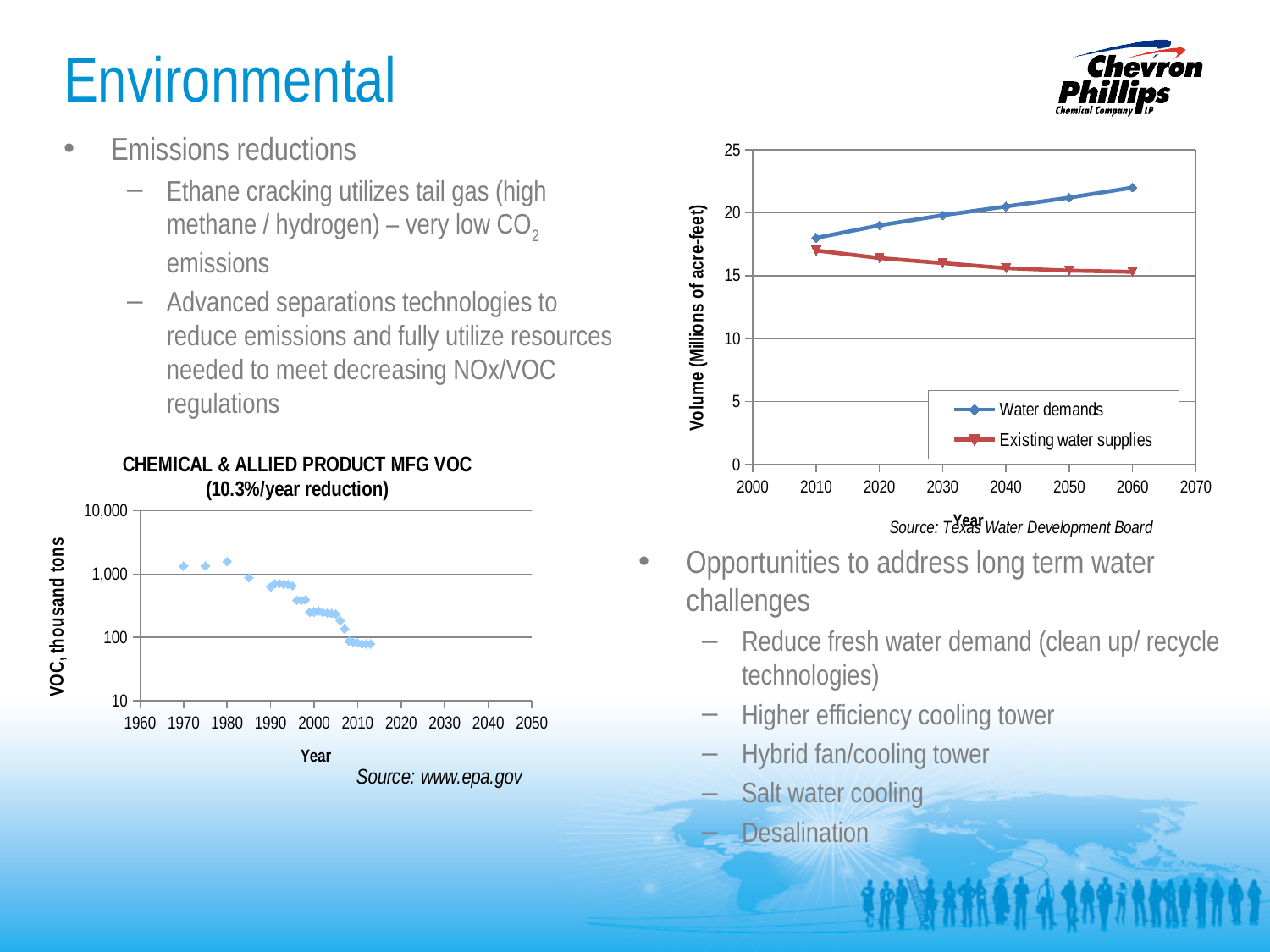
On the water chart on the right, how many data points are plotted for the Water demands series? 6 On the water chart on the right, do the Water demands values rise or fall from 2010 to 2060? rise On the water chart on the right, which series has the larger value in 2060, Water demands or Existing water supplies? Water demands On the water chart on the right, is the Water demands value for 2010 greater or less than 20? less On the water chart on the right, is the Existing water supplies value for 2060 greater or less than 20? less What is the title of the chart on the left of the slide? CHEMICAL & ALLIED PRODUCT MFG VOC (10.3%/year reduction) On the water chart on the right, do the Existing water supplies values rise or fall from 2010 to 2060? fall On the VOC chart on the left, do the values rise or fall from 1970 to 2010? fall On the water chart on the right, is the Water demands value for 2060 greater or less than 20? greater On the water chart on the right, what are the two series named in the legend? Water demands; Existing water supplies On the water chart on the right, how many series does the legend list? 2